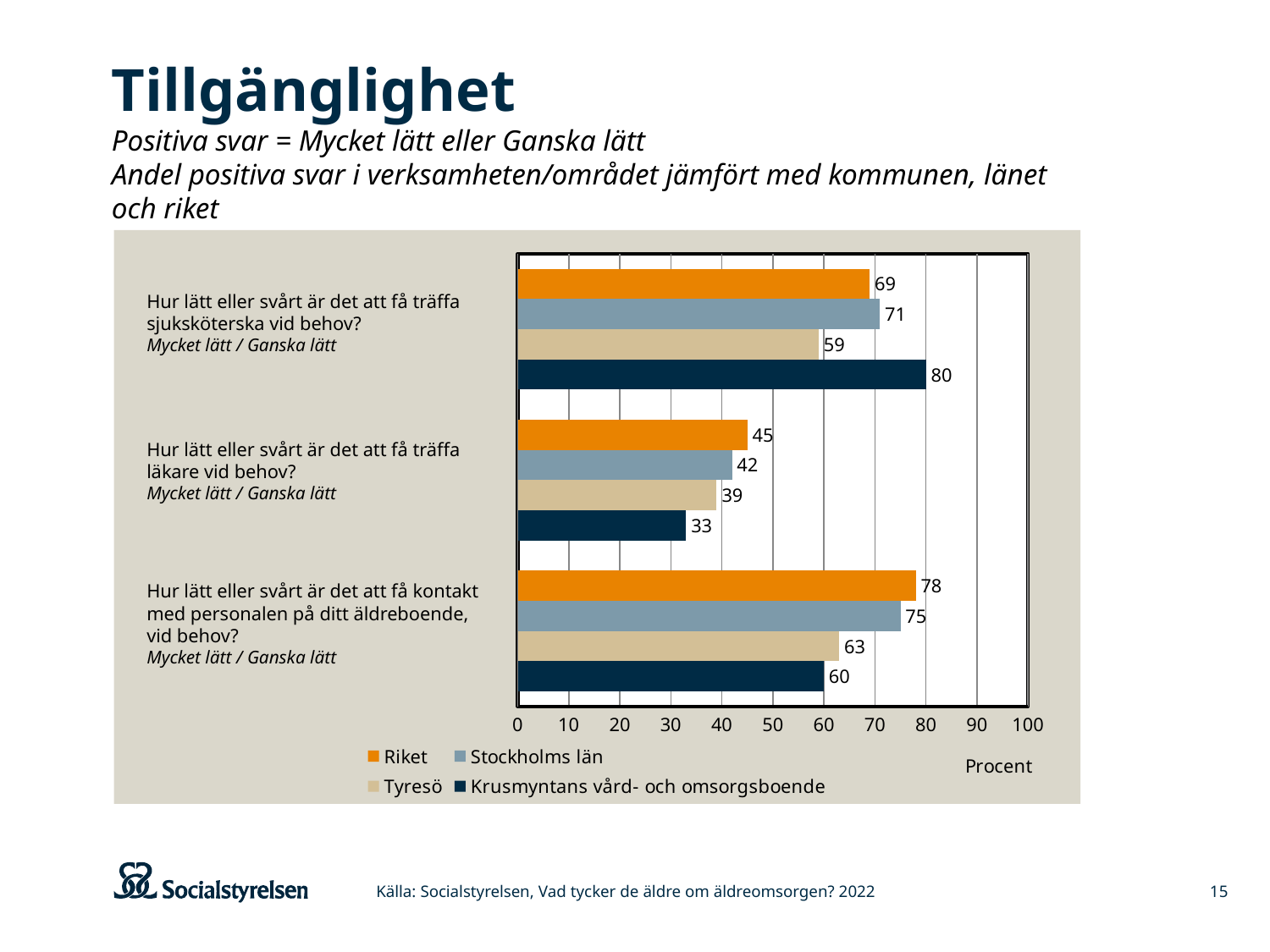
What is the value for Riket on the question about getting in contact with staff at the care home when needed? 78 Which series has the lowest value on the question about meeting a doctor (läkare) when needed? Krusmyntans vård- och omsorgsboende How many question categories are shown on the chart? 3 What is the value for Stockholms län on the question about meeting a doctor (läkare) when needed? 42 What unit label is shown below the x axis of the chart? Procent What is the value for Tyresö on the question about meeting a doctor (läkare) when needed? 39 Which series has the highest value on the question about meeting a nurse (sjuksköterska) when needed? Krusmyntans vård- och omsorgsboende How many series does the legend list? 4 What is the difference between Riket and Krusmyntans vård- och omsorgsboende on the question about getting in contact with staff at the care home? 18 Which is larger on the question about meeting a nurse (sjuksköterska): Riket or Stockholms län? Stockholms län What is the value for Krusmyntans vård- och omsorgsboende on the question about meeting a nurse (sjuksköterska) when needed? 80 What kind of chart is shown on the slide? Bar chart